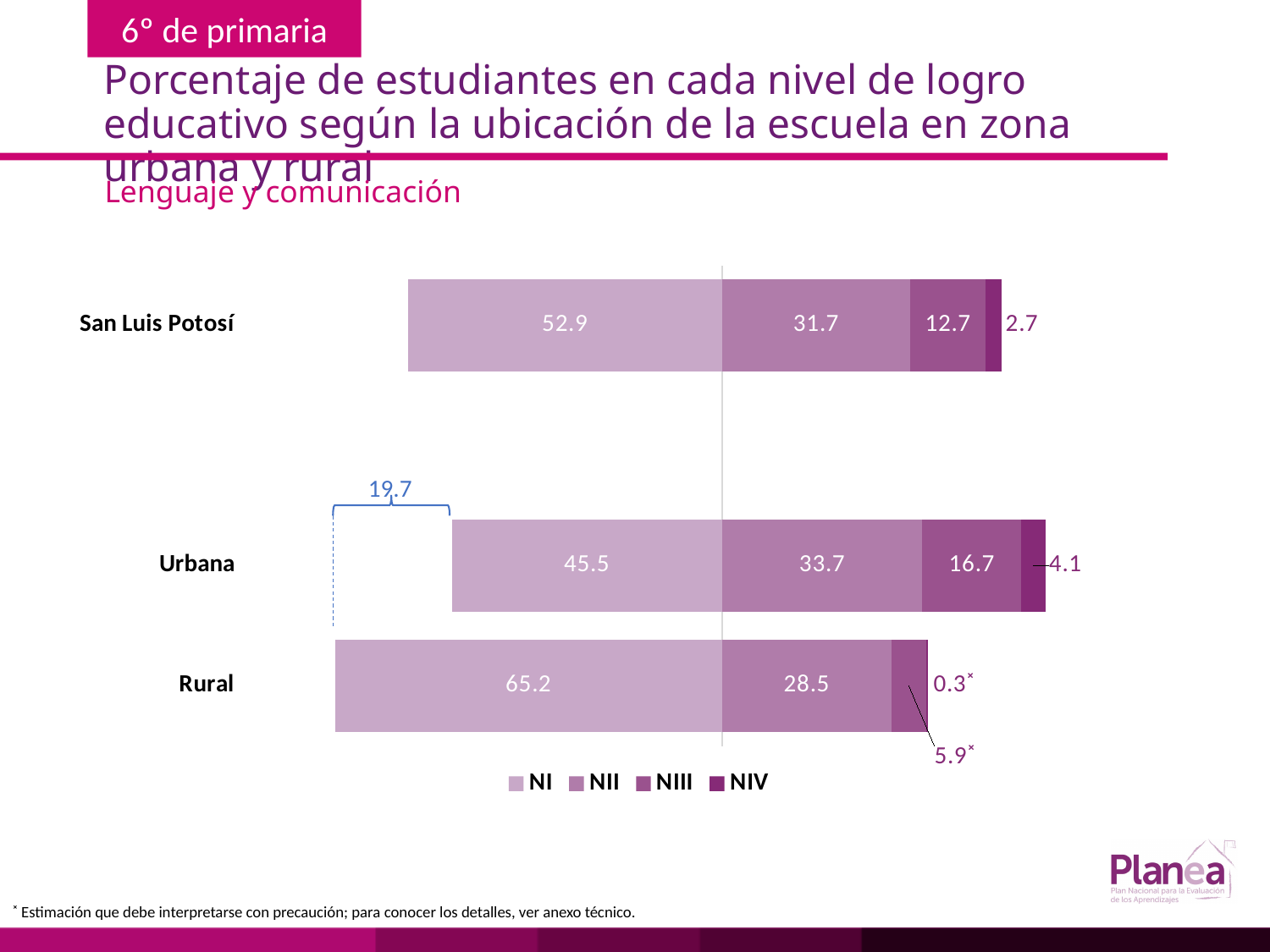
How many categories (bars) are shown in the chart? 3 Which category has the lowest NIV value? Rural What is the NI value for San Luis Potosí? 52.9 Which is larger, the NII value for San Luis Potosí or the NII value for Rural? San Luis Potosí What is the NII value for Urbana? 33.7 What is the subtitle shown below the chart title? Lenguaje y comunicación What is the difference between the NI values for Rural and Urbana? 19.7 What type of chart is shown on the slide? Stacked bar chart How many series does the legend list? 4 What is the NIV value for Rural? 0.3* What is the NIII value for Urbana? 16.7 Which category has the highest NI value? Rural